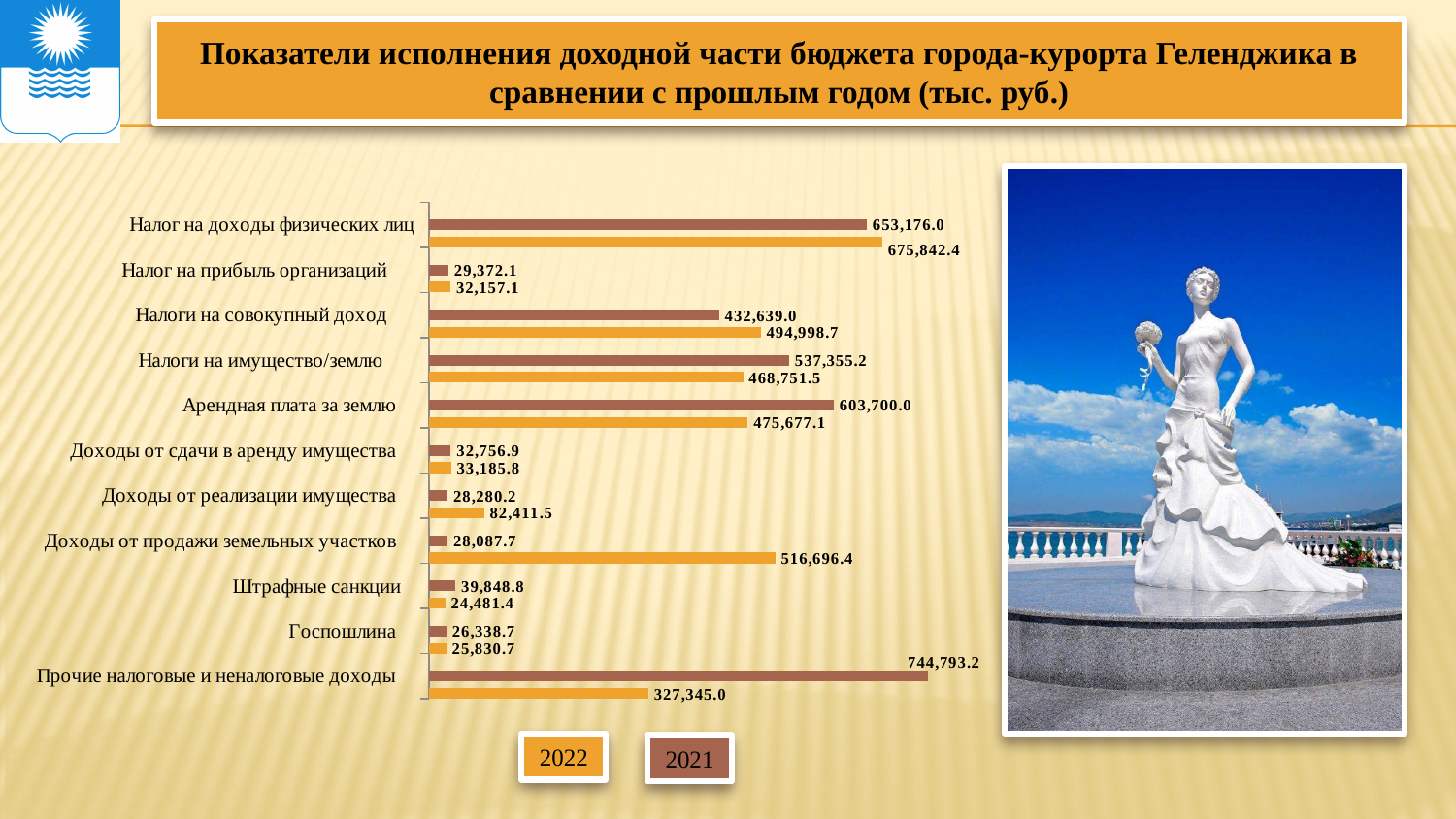
What is the 2021 value for Арендная плата за землю? 603,700.0 Which category has the highest 2021 value? Прочие налоговые и неналоговые доходы Which category has the lowest 2022 value? Штрафные санкции How many categories are shown on the chart? 11 What is the 2022 value for Налог на доходы физических лиц? 675,842.4 What kind of chart is shown on the slide? Bar chart What is the difference between the 2021 and 2022 values for Прочие налоговые и неналоговые доходы? 417,448.2 What is the difference between the 2022 and 2021 values for Налог на доходы физических лиц? 22,666.4 For Налоги на имущество/землю, which year has the larger value, 2021 or 2022? 2021 What is the 2022 value for Доходы от продажи земельных участков? 516,696.4 For Налоги на совокупный доход, which year has the larger value, 2021 or 2022? 2022 How many series does the legend list? 2